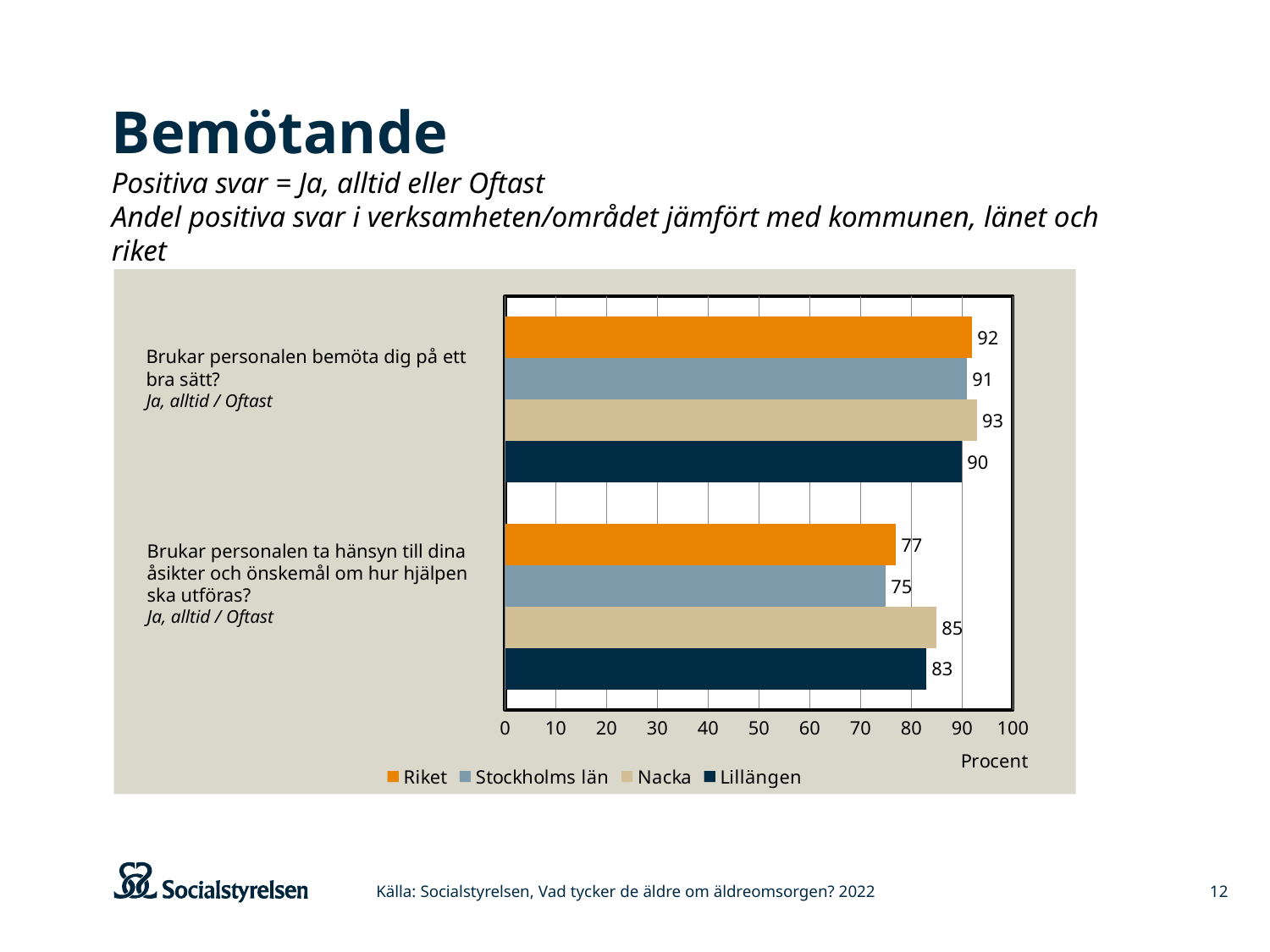
Which is larger on the question 'Brukar personalen ta hänsyn till dina åsikter och önskemål om hur hjälpen ska utföras?': Lillängen or Riket? Lillängen What value is shown for Lillängen on the question 'Brukar personalen ta hänsyn till dina åsikter och önskemål om hur hjälpen ska utföras?' 83 What value is shown for Riket on the question 'Brukar personalen ta hänsyn till dina åsikter och önskemål om hur hjälpen ska utföras?' 77 Which series has the lowest value on the question 'Brukar personalen bemöta dig på ett bra sätt?' Lillängen What value is shown for Stockholms län on the question 'Brukar personalen bemöta dig på ett bra sätt?' 91 What kind of chart is shown on the slide? bar chart Is the value for Stockholms län on the question 'Brukar personalen ta hänsyn till dina åsikter och önskemål om hur hjälpen ska utföras?' greater or less than 80? less What is the label on the horizontal axis of the chart? Procent What is the difference between the Nacka and Stockholms län values on the question 'Brukar personalen ta hänsyn till dina åsikter och önskemål om hur hjälpen ska utföras?' 10 How many series does the legend list? 4 Which series has the highest value on the question 'Brukar personalen ta hänsyn till dina åsikter och önskemål om hur hjälpen ska utföras?' Nacka What value is shown for Nacka on the question 'Brukar personalen bemöta dig på ett bra sätt?' 93